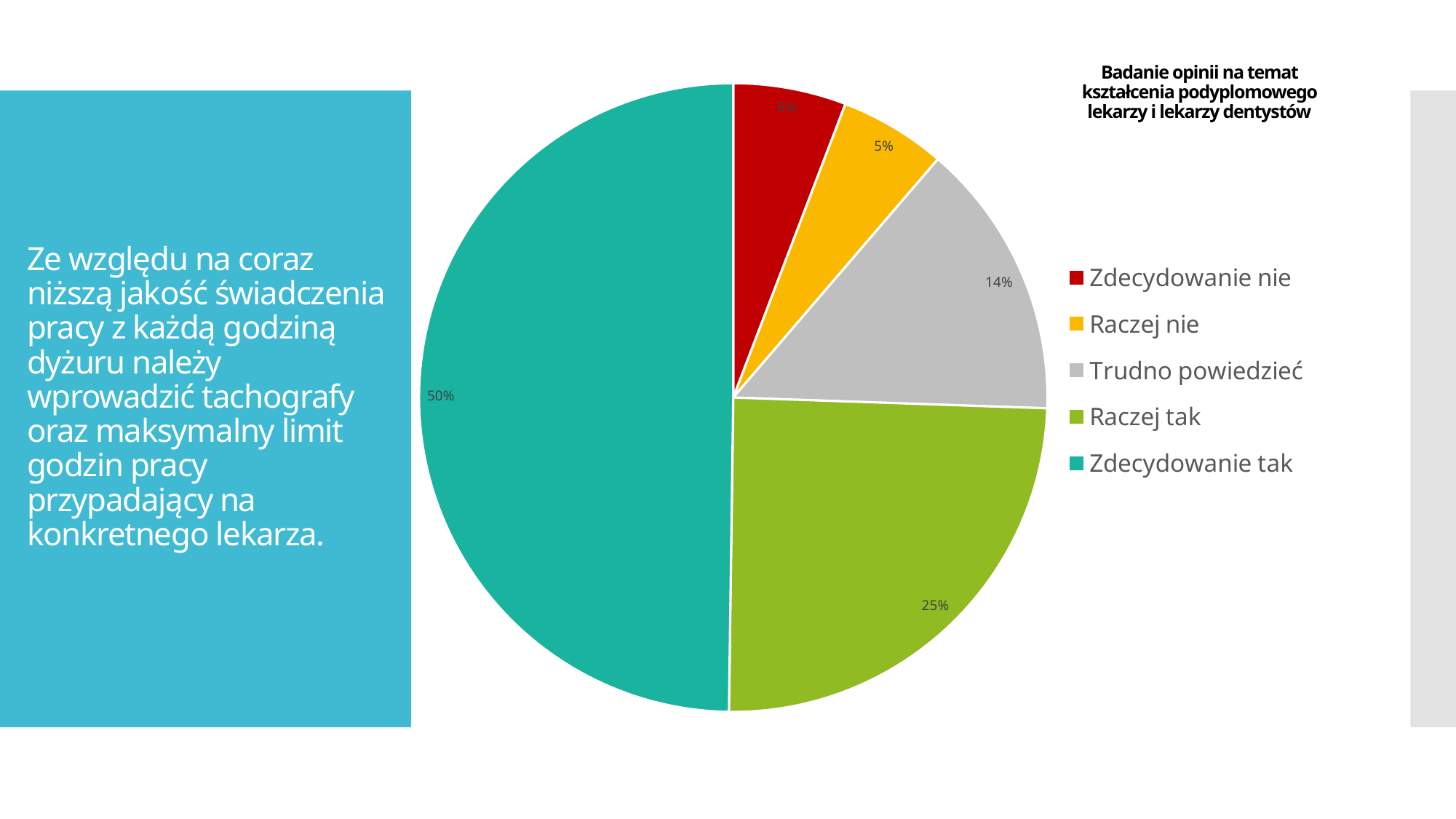
What is the title of the chart? Badanie opinii na temat kształcenia podyplomowego lekarzy i lekarzy dentystów What colour is the slice for "Trudno powiedzieć"? grey What share of the pie does "Zdecydowanie tak" have? 50% How many categories does the pie chart have? 5 Which category has the smallest slice of the pie? Raczej nie Which category has the largest slice of the pie? Zdecydowanie tak What is the difference between the values for "Zdecydowanie tak" and "Raczej tak"? 25% What is the value for "Raczej nie"? 5% Which is larger, the value for "Trudno powiedzieć" or the value for "Raczej tak"? Raczej tak What kind of chart is shown on the slide? pie chart What is the value for "Raczej tak"? 25% What is the value for "Trudno powiedzieć"? 14%